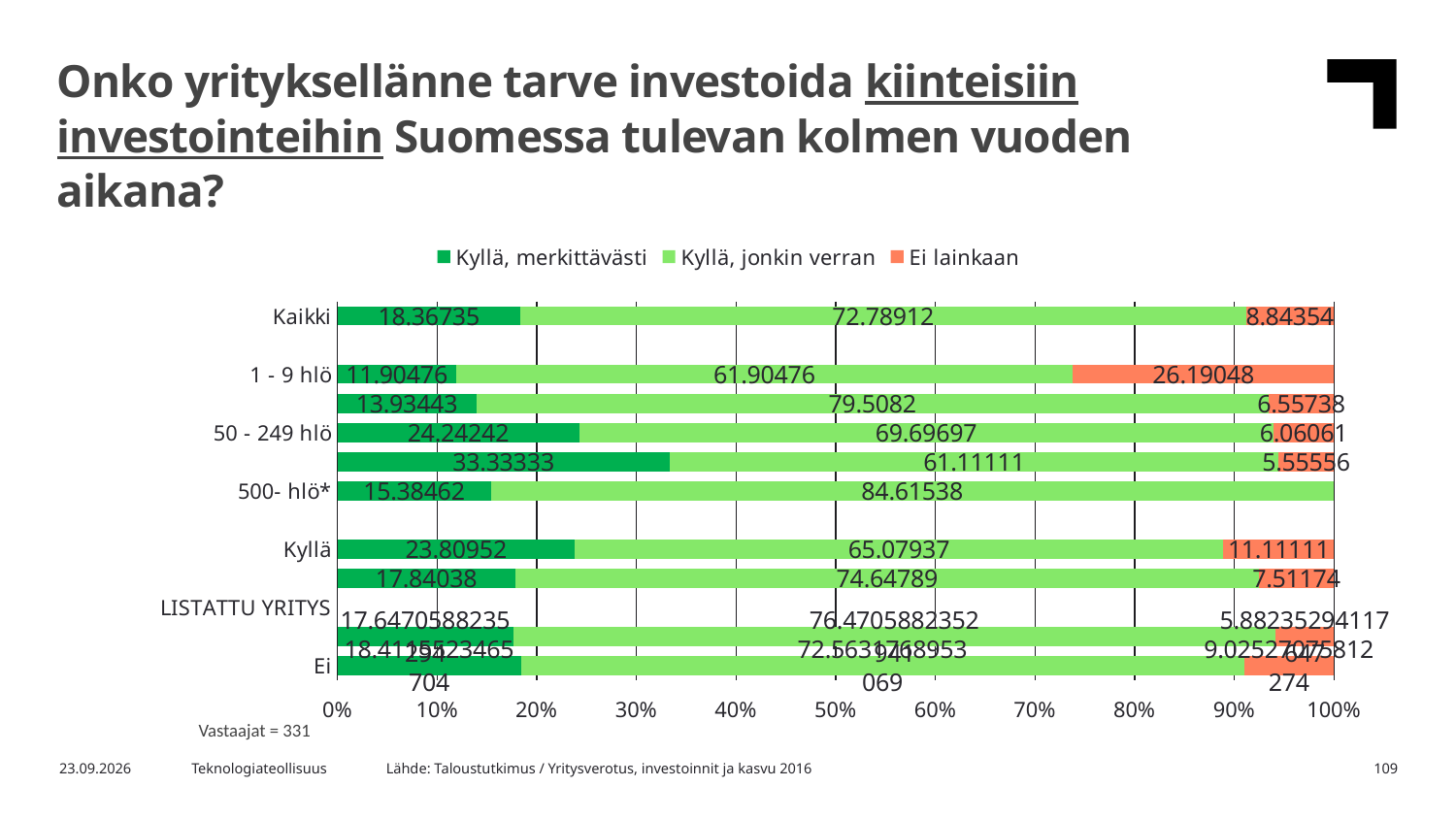
What is the value of "Kyllä, jonkin verran" for the 500- hlö* category? 84.61538 For the Kaikki category, what is the difference between the "Kyllä, jonkin verran" value and the "Kyllä, merkittävästi" value? 54.42177 Which is larger: the "Kyllä, merkittävästi" value for 50 - 249 hlö or for Kaikki? 50 - 249 hlö What is the value of "Ei lainkaan" for the 1 - 9 hlö category? 26.19048 Which category has the highest "Kyllä, jonkin verran" value? 500- hlö* How many series does the legend list? 3 What is the value of "Ei lainkaan" for the Kyllä category? 11.11111 What is the value of "Kyllä, jonkin verran" for the Kaikki category? 72.78912 Which category has the lowest "Kyllä, merkittävästi" value? 1 - 9 hlö Which category has the highest "Ei lainkaan" value? 1 - 9 hlö What is the value of "Kyllä, merkittävästi" for the 50 - 249 hlö category? 24.24242 What kind of chart is shown on the slide? Stacked bar chart